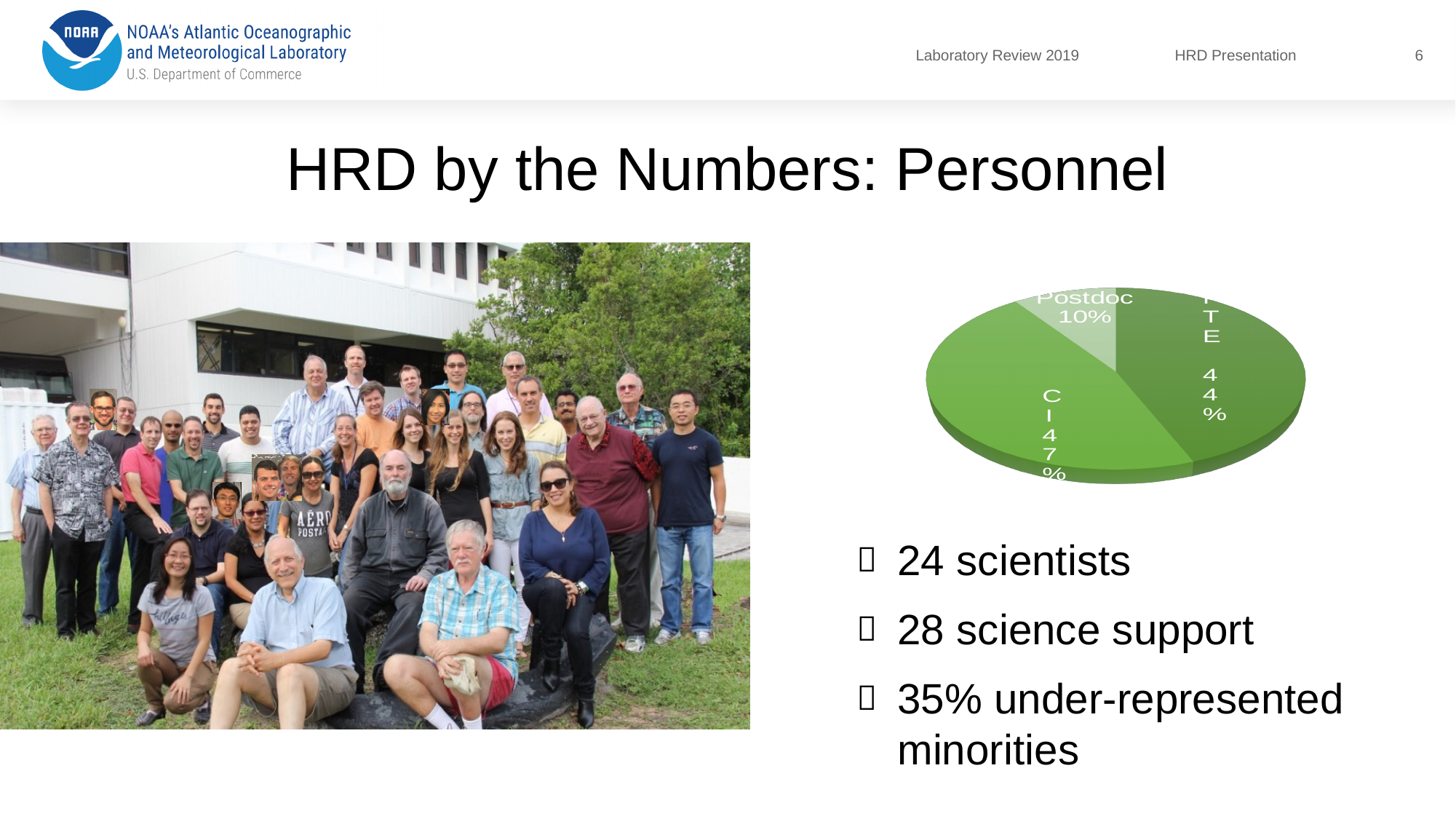
What colour scheme is used for the slices of the pie chart? shades of green Which is larger in the pie chart, CI or Postdoc? CI Which slice of the pie chart is the smallest? Postdoc What kind of chart is shown on the slide? pie chart Which slice of the pie chart is the largest? CI What share of the pie chart is CI? 47% Is the share for Postdoc greater or less than 25%? less What is the difference in percentage points between the CI slice and the Postdoc slice? 37 What is the difference in percentage points between the CI slice and the FTE slice? 3 What share of the pie chart is FTE? 44% What share of the pie chart is Postdoc? 10% How many slices does the pie chart have? 3